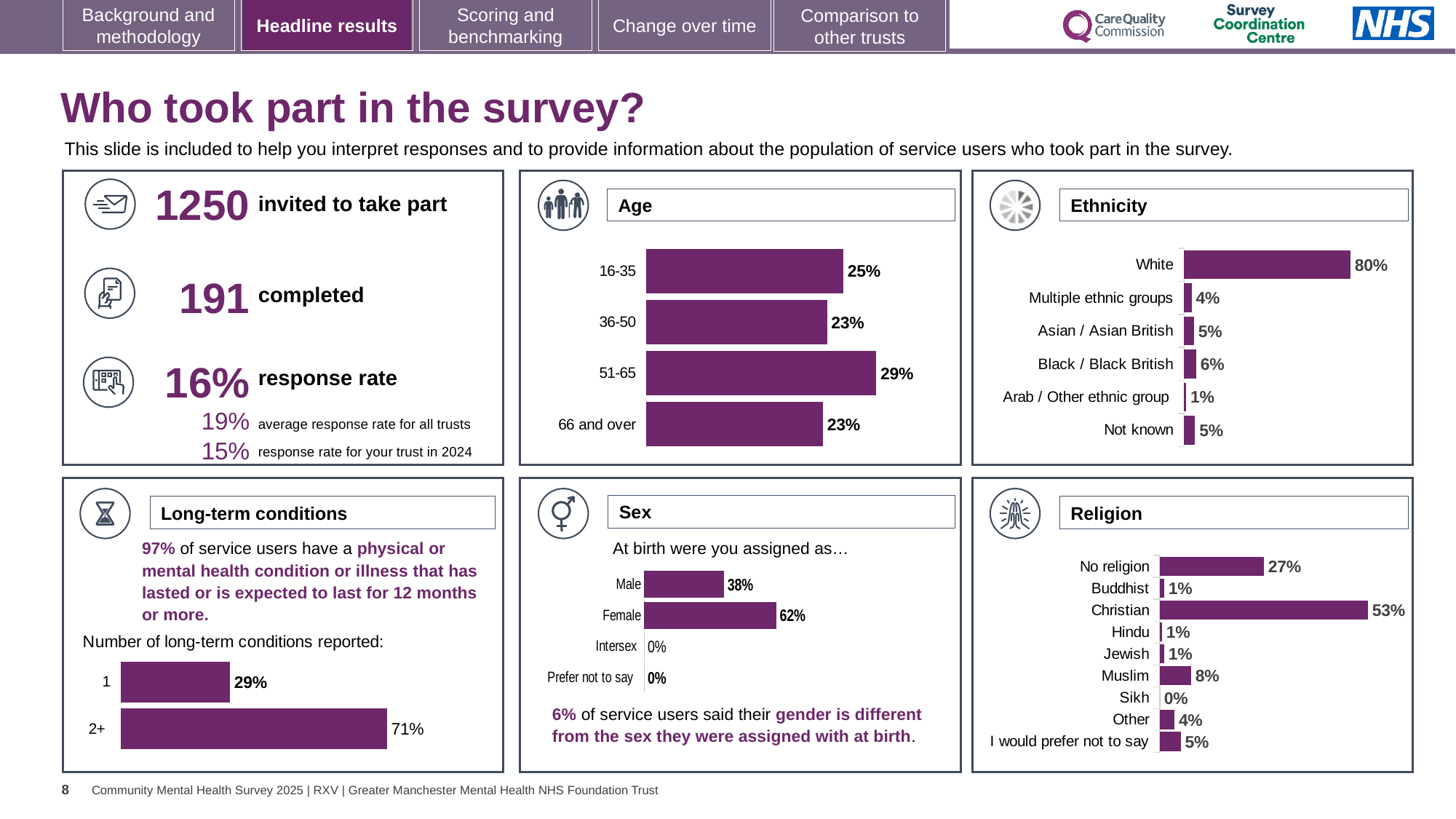
In the Sex chart, what is the difference between the Female and Male percentages? 24% In the Ethnicity chart, what percentage of respondents were White? 80% In the Religion chart, what percentage of respondents reported No religion? 27% In the Religion chart, how many categories are shown? 9 In the Ethnicity chart, what is the difference between the White and Black / Black British percentages? 74% In the Age chart, what percentage of respondents were aged 51-65? 29% In the Religion chart, which religion category has the highest percentage? Christian In the Ethnicity chart, which category has the lowest percentage? Arab / Other ethnic group In the Sex chart, what percentage of respondents were assigned Female at birth? 62% In the Long-term conditions chart, which is larger: the percentage reporting 1 condition or 2+ conditions? 2+ What type of chart is used in the Age panel? Bar chart In the Age chart, which age group has the highest percentage? 51-65